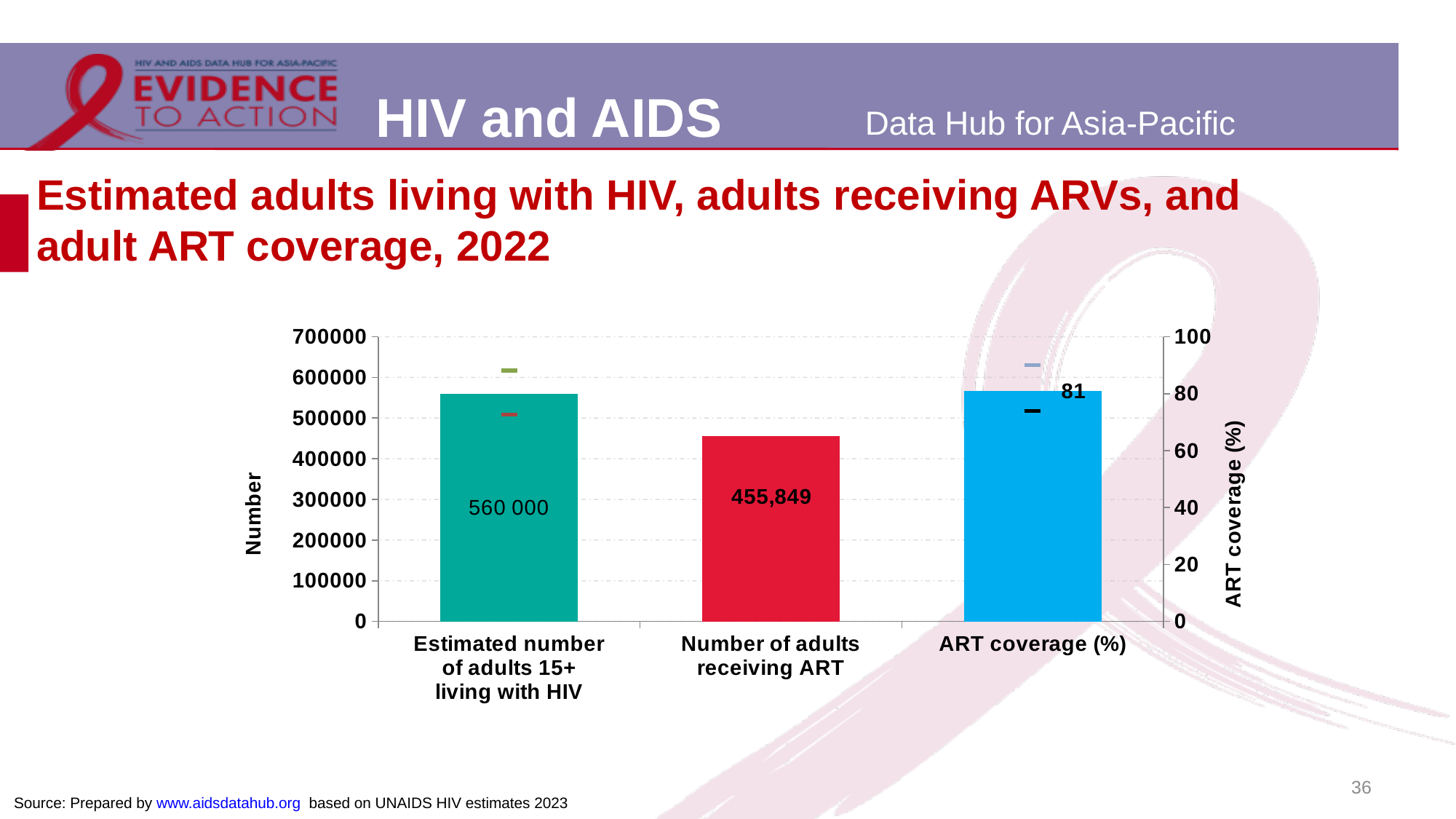
Is the value for the estimated number of adults 15+ living with HIV greater or less than 500000? greater What is the title of the left vertical axis? Number What is the ART coverage (%) value shown on the chart? 81 What is the value shown for the estimated number of adults 15+ living with HIV? 560 000 What is the value shown for the number of adults receiving ART? 455,849 What kind of chart is shown on the slide? Bar chart What is the difference between the estimated number of adults 15+ living with HIV and the number of adults receiving ART? 104,151 What is the title of the right vertical axis? ART coverage (%) How many categories are shown on the x axis of the chart? 3 Which is larger: the estimated number of adults 15+ living with HIV or the number of adults receiving ART? Estimated number of adults 15+ living with HIV Is the value for the number of adults receiving ART greater or less than 500000? less